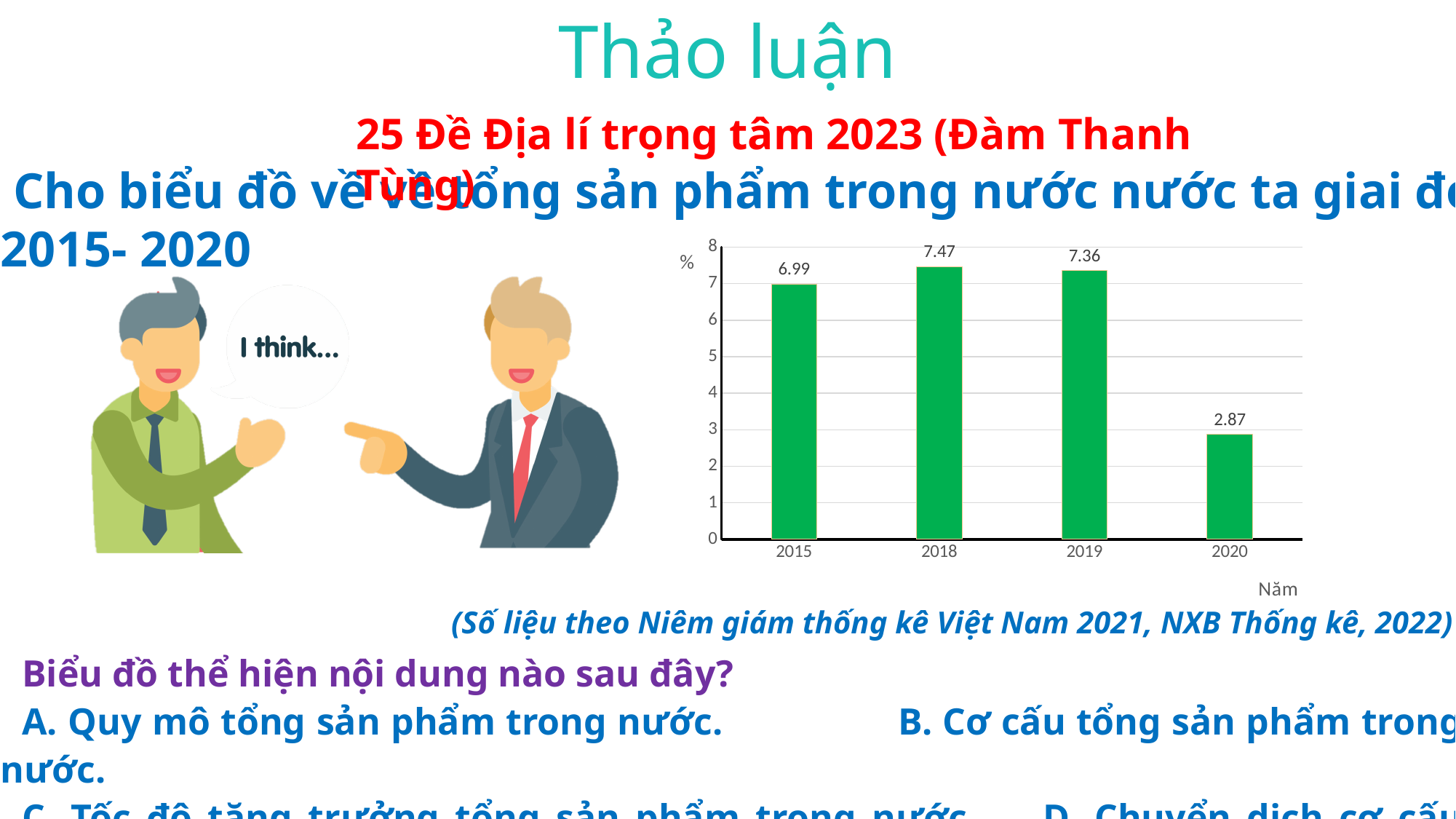
Which year has the highest value? 2018 What kind of chart is shown? bar chart What is the value for 2019? 7.36 Is the value for 2020 greater or less than 3? less What is the difference between the values for 2018 and 2015? 0.48 What is the difference between the values for 2018 and 2020? 4.60 What is the value for 2015? 6.99 Which is larger, the value for 2015 or the value for 2020? 2015 Which year has the lowest value? 2020 How many years are shown on the x axis? 4 What is the value for 2020? 2.87 What is the value for 2018? 7.47